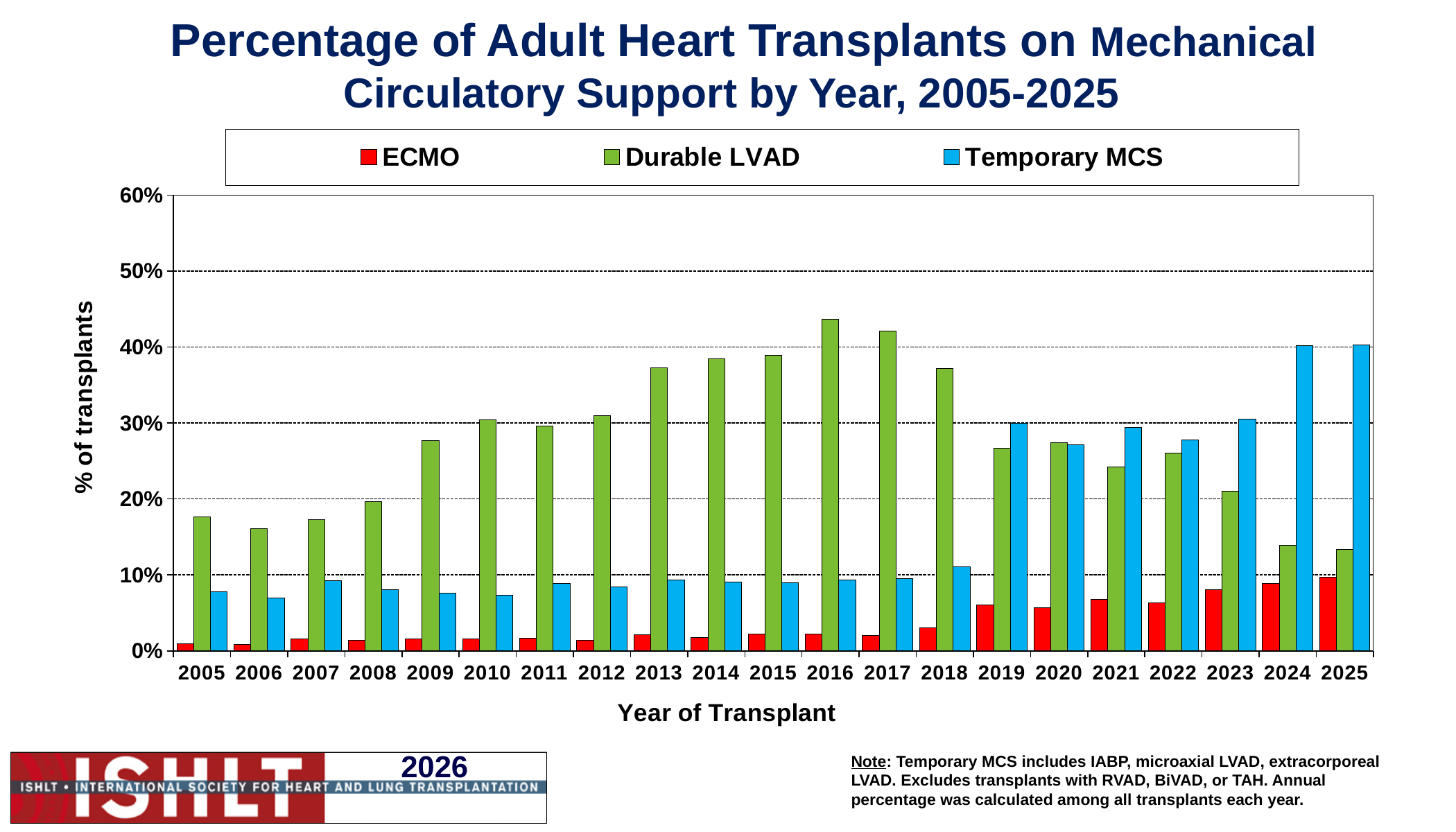
In which year is the Durable LVAD percentage highest? 2016 How many series does the legend list? 3 What colour represents ECMO in the legend? red In 2025, which is larger: Temporary MCS or Durable LVAD? Temporary MCS Is the Temporary MCS value for 2024 greater or less than 30%? greater Is the Durable LVAD value for 2016 greater or less than 40%? greater Does the Durable LVAD percentage rise or fall from 2017 to 2025? fall In 2010, which is larger: Durable LVAD or Temporary MCS? Durable LVAD What kind of chart is shown on the slide? bar chart Is the Durable LVAD value for 2005 greater or less than 20%? less How many years are shown on the x axis? 21